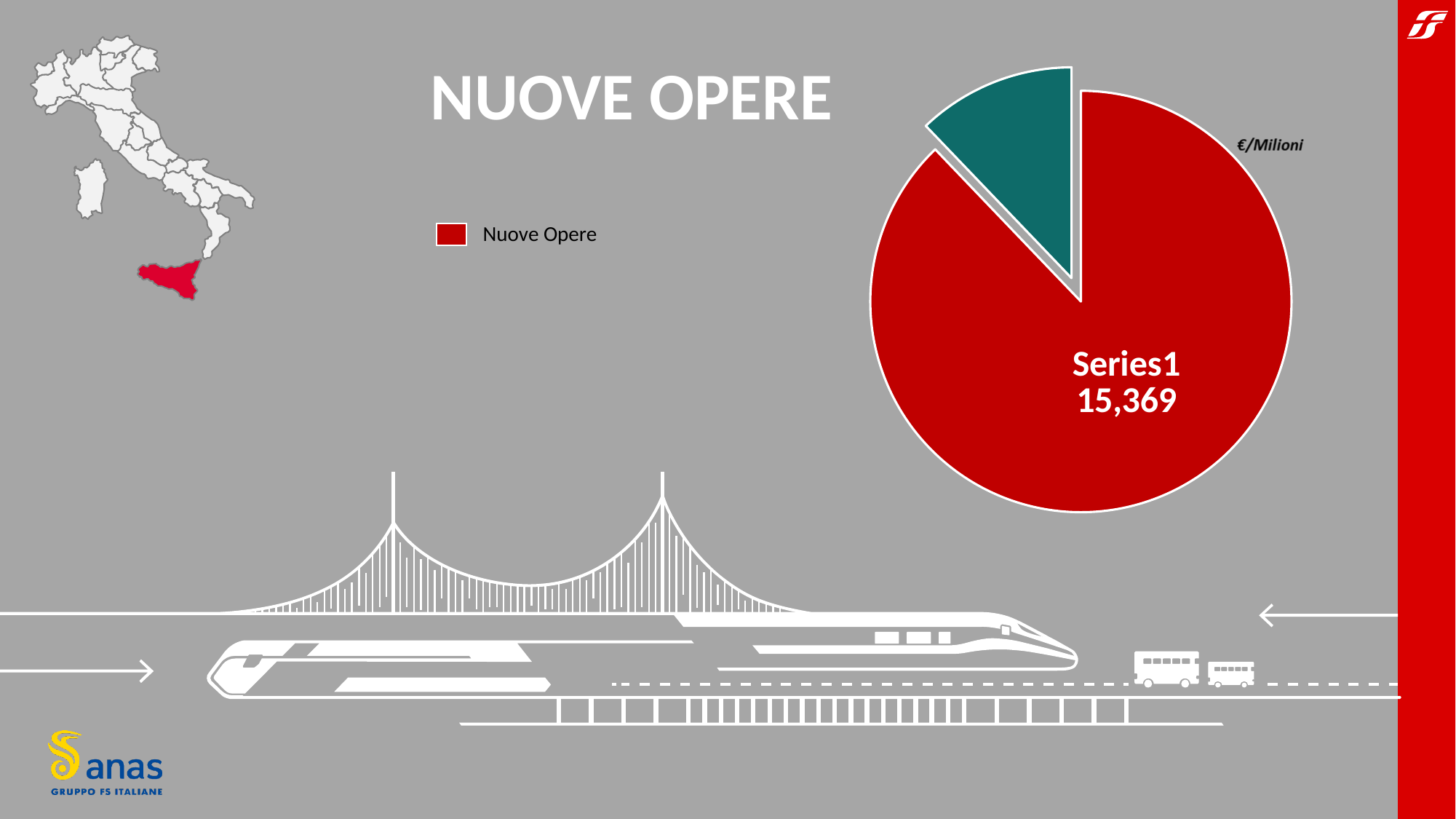
What label is printed on the red slice of the pie chart? Series1 Is the value of the red slice greater or less than 10,000? greater Is the red slice or the teal slice of the pie chart larger? the red slice What entry does the legend of the pie chart list? Nuove Opere What unit is indicated next to the pie chart? €/Milioni How many slices does the pie chart have? 2 What kind of chart is shown on the slide? pie chart Which slice of the pie chart is the largest? the red slice (Series1) Which slice of the pie chart is the smallest? the teal slice What value is printed on the red slice of the pie chart? 15,369